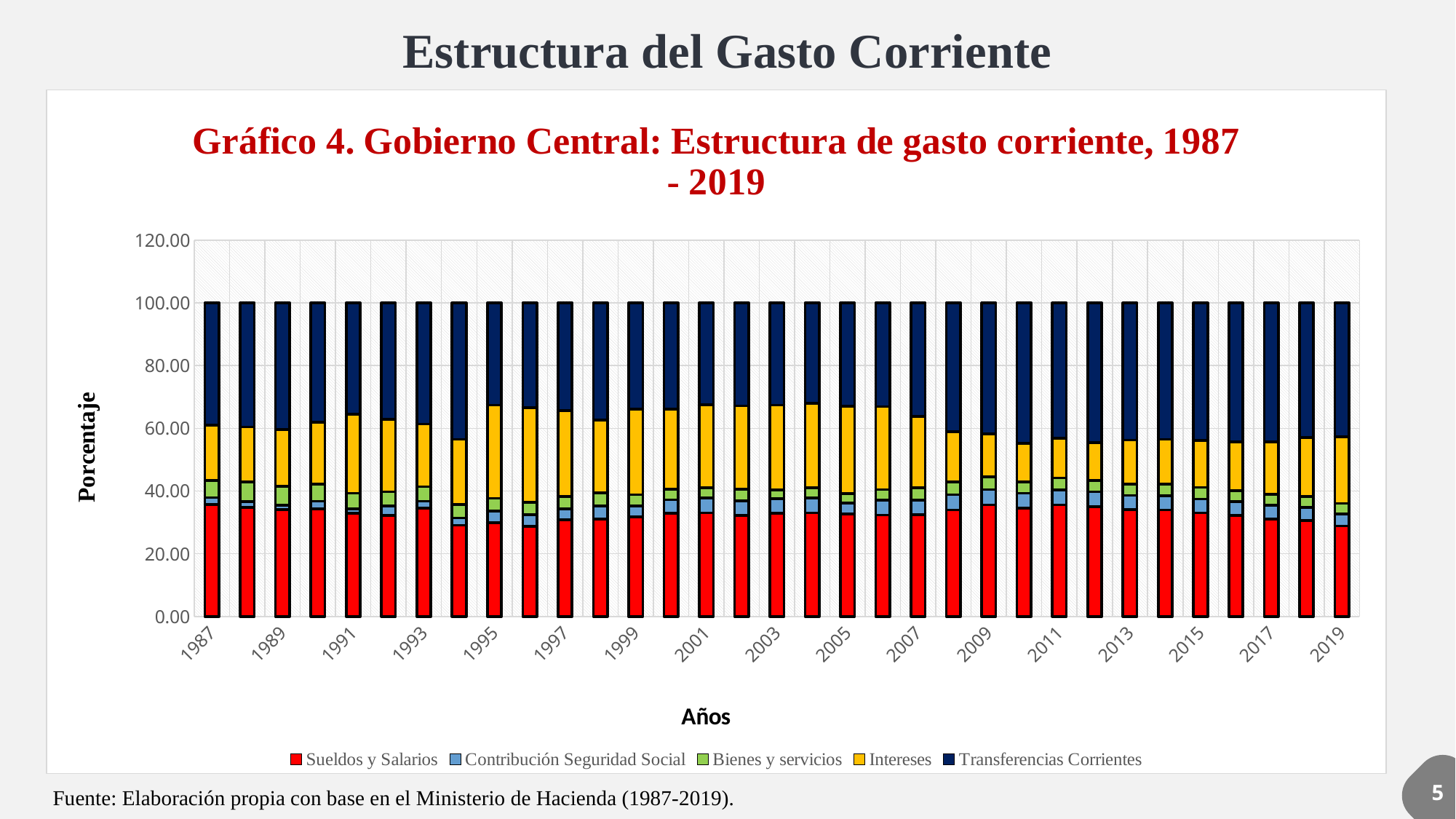
Is the value for Sueldos y Salarios in 2011 greater or less than 20? greater What is the label on the y axis of the chart? Porcentaje What kind of chart is shown on the slide? Stacked bar chart What is the total height of each stacked bar in the chart? 100.00 How many series does the legend list? 5 How many years (bars) are plotted in the chart? 33 Which series is shown in red in the chart? Sueldos y Salarios Which series occupies the top segment of each stacked bar? Transferencias Corrientes Is the value for Sueldos y Salarios in 1987 greater or less than 40? less Is the value for Sueldos y Salarios in 2019 greater or less than 20? greater What is the first year shown on the x axis of the chart? 1987